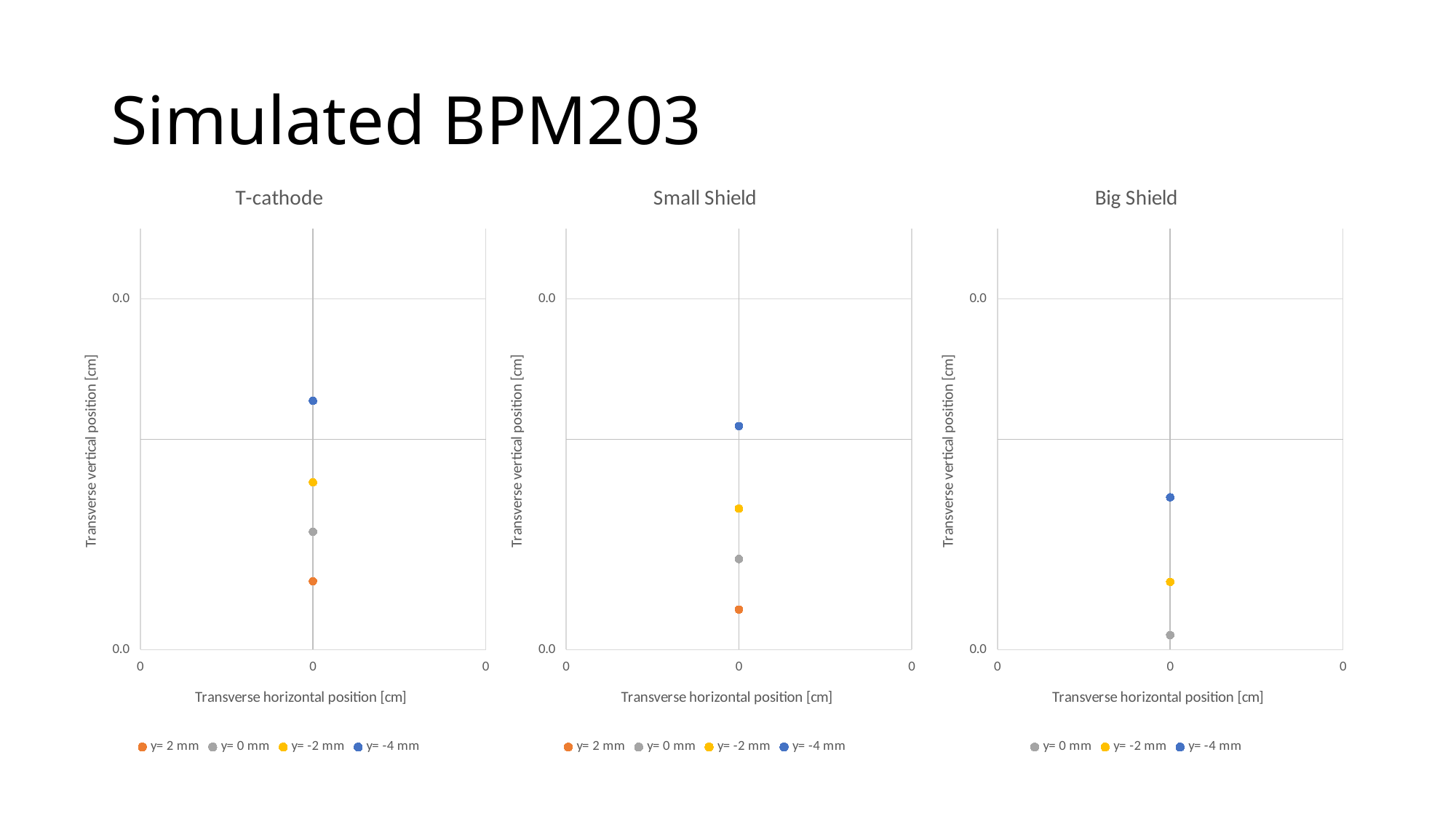
What is the x-axis title of the Small Shield chart? Transverse horizontal position [cm] In the Small Shield chart, which series is plotted at the highest vertical position? y= -4 mm In the Small Shield chart, which is plotted higher, y= 0 mm or y= -2 mm? y= -2 mm How many series does the legend of the Big Shield chart list? 3 Which legend entry appears in the T-cathode chart but not in the Big Shield chart? y= 2 mm What kind of chart is the T-cathode chart? scatter chart In the T-cathode chart, which series is plotted at the lowest vertical position? y= 2 mm In the T-cathode chart, which series is plotted at the highest vertical position? y= -4 mm In the Big Shield chart, which series is plotted at the lowest vertical position? y= 0 mm How many data points are plotted in the Big Shield chart? 3 How many charts are shown on the slide? 3 How many series does the legend of the T-cathode chart list? 4